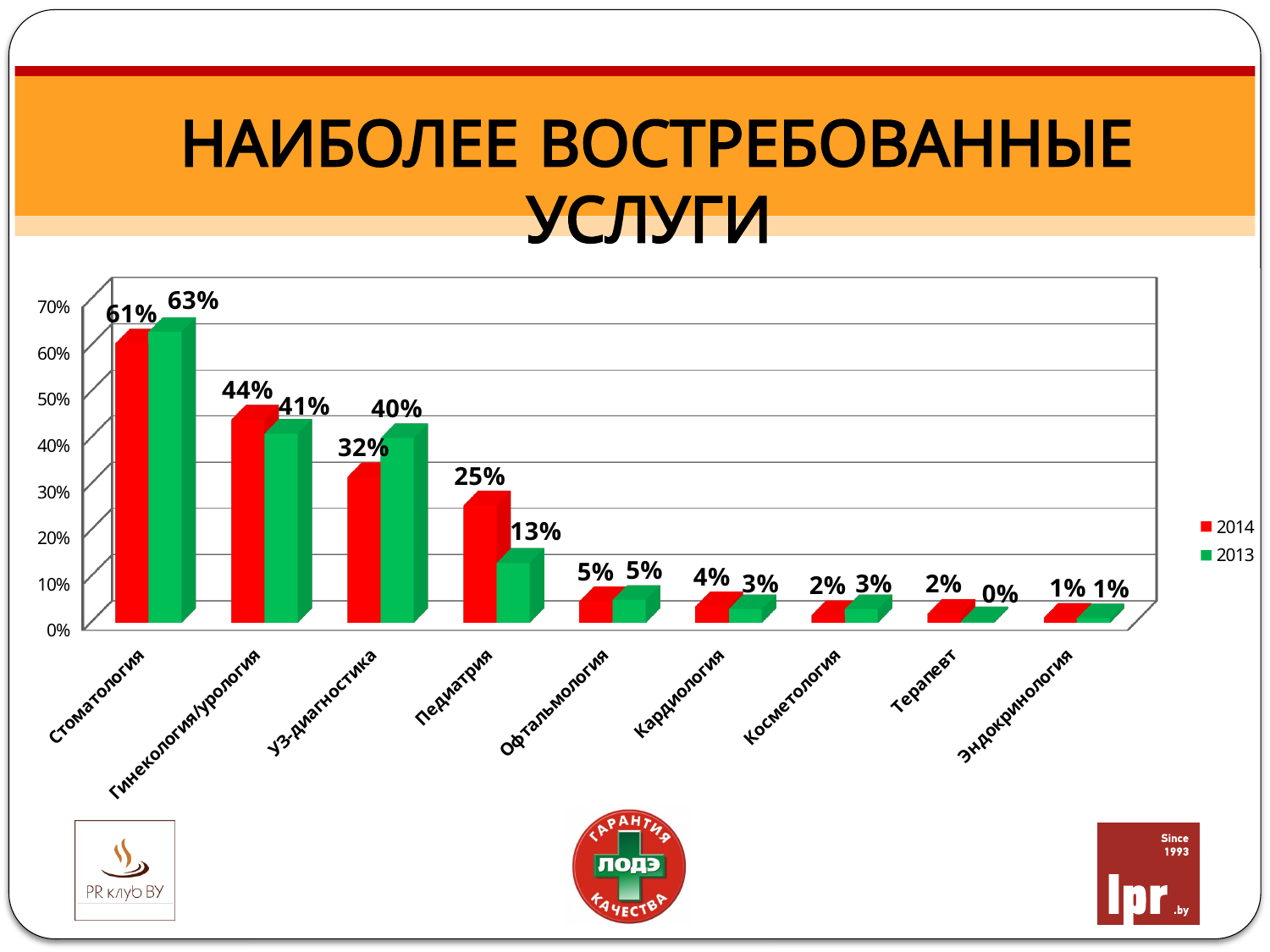
What is the 2014 value for Стоматология? 61% How many series does the legend list? 2 What kind of chart is shown on the slide? Bar chart What colour represents the 2013 series? Green What is the difference between the 2014 and 2013 values for Педиатрия? 12% How many categories are shown on the x axis? 9 Do the 2014 values rise or fall from left to right along the x axis? Fall Which is larger for Гинекология/урология: the 2014 value or the 2013 value? 2014 Which category has the lowest 2013 value? Терапевт Which category has the highest 2013 value? Стоматология What is the 2013 value for Педиатрия? 13% What is the 2014 value for УЗ-диагностика? 32%